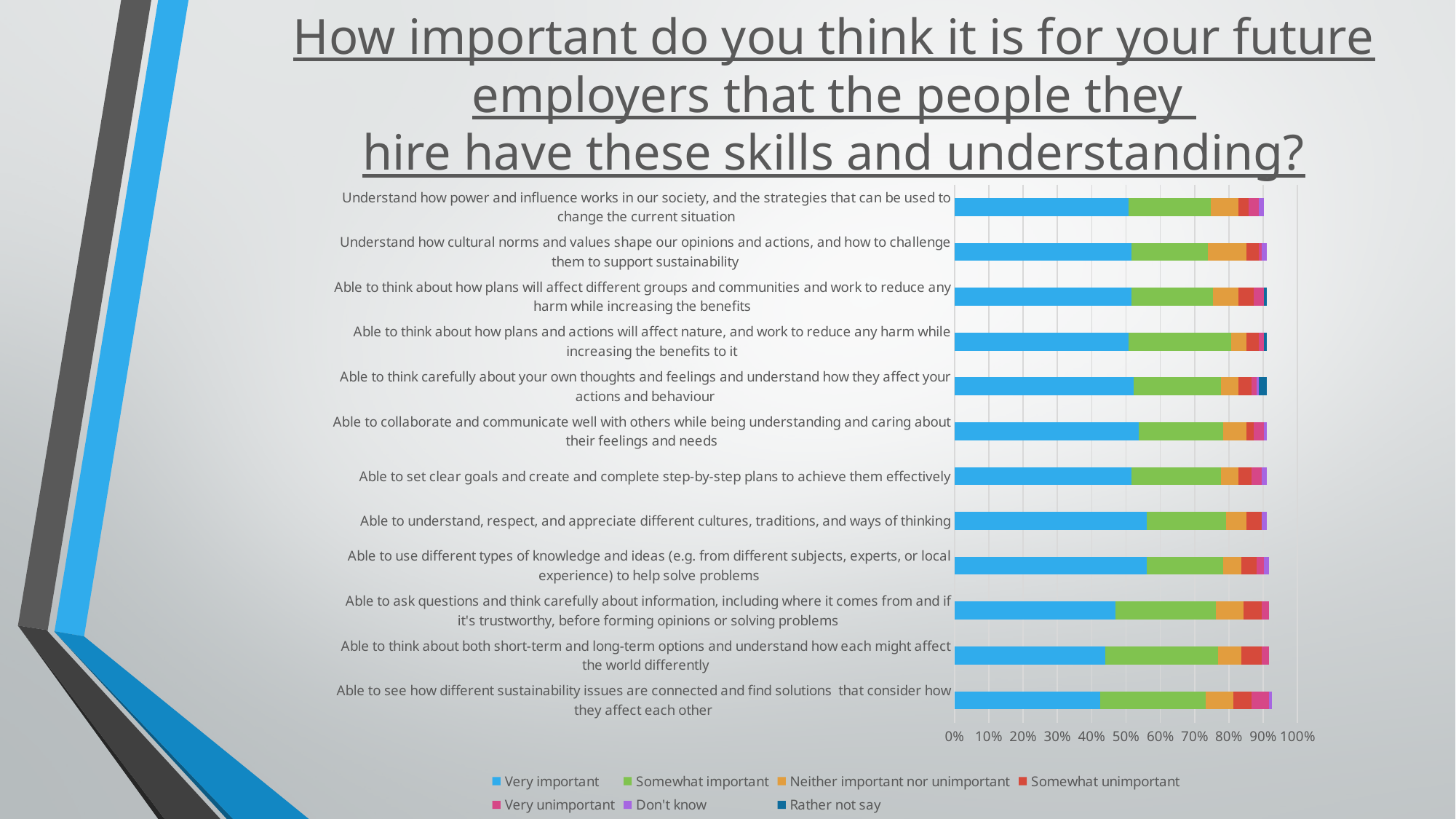
Which has the larger 'Very important' share: 'Able to understand, respect, and appreciate different cultures, traditions, and ways of thinking' or 'Able to see how different sustainability issues are connected and find solutions that consider how they affect each other'? Able to understand, respect, and appreciate different cultures, traditions, and ways of thinking Is the 'Very important' value for 'Able to use different types of knowledge and ideas (e.g. from different subjects, experts, or local experience) to help solve problems' greater or less than 50%? greater How many skill statements (categories) are plotted on the chart? 12 Which legend entry is shown in blue? Very important What kind of chart is shown on the slide? Stacked bar chart Is the 'Very important' value for 'Able to see how different sustainability issues are connected and find solutions that consider how they affect each other' greater or less than 50%? less Is the 'Very important' value for 'Able to think about both short-term and long-term options and understand how each might affect the world differently' greater or less than 50%? less How many series does the legend list? 7 What is the last entry in the chart's legend? Rather not say What is the highest percentage tick shown on the horizontal axis? 100%